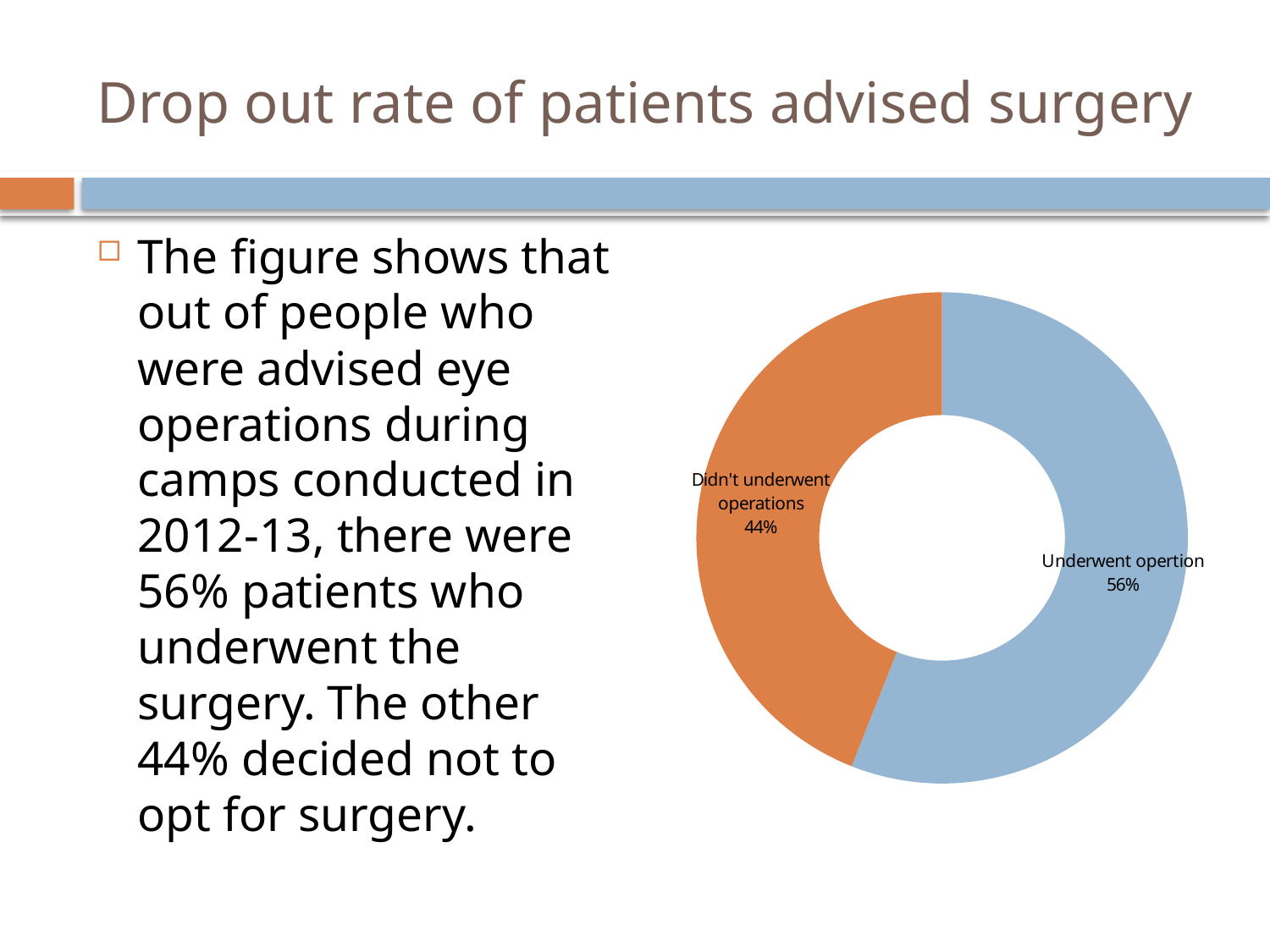
How many categories are shown in the chart? 2 What percentage of patients underwent operation? 56% What colour is the 'Underwent opertion' slice? Blue Which category has the smaller share of the chart? Didn't underwent operations Which category has the larger share of the chart? Underwent opertion Is the share for 'Underwent opertion' larger or smaller than the share for 'Didn't underwent operations'? Larger What colour is the 'Didn't underwent operations' slice? Orange What share of the chart does the 'Didn't underwent operations' slice represent? 44% What is the difference in percentage points between patients who underwent operation and those who didn't? 12 What kind of chart is shown on the slide? Doughnut chart What percentage of patients didn't undergo operations? 44%